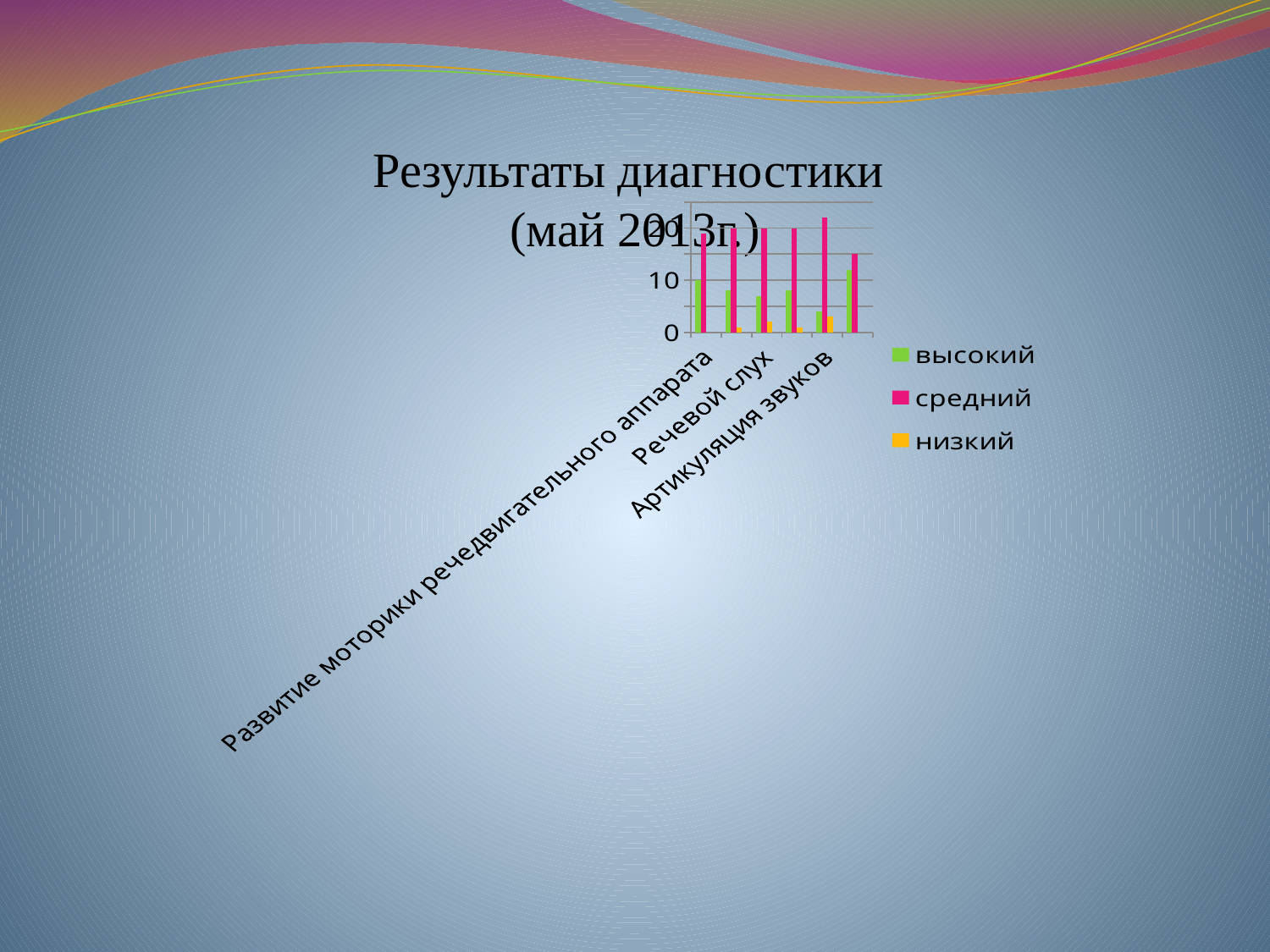
In the first group of bars (Развитие моторики речедвигательного аппарата), which series has the highest value? средний What are the series names listed in the chart legend? высокий, средний, низкий What kind of chart is shown on the slide? bar chart In the first group of bars (Развитие моторики речедвигательного аппарата), which is larger: the value for высокий or the value for средний? средний How many series does the chart legend list? 3 Is the value for средний in the first group of bars (Развитие моторики речедвигательного аппарата) greater or less than 10? greater Across all groups of bars, which series consistently has the tallest bar? средний